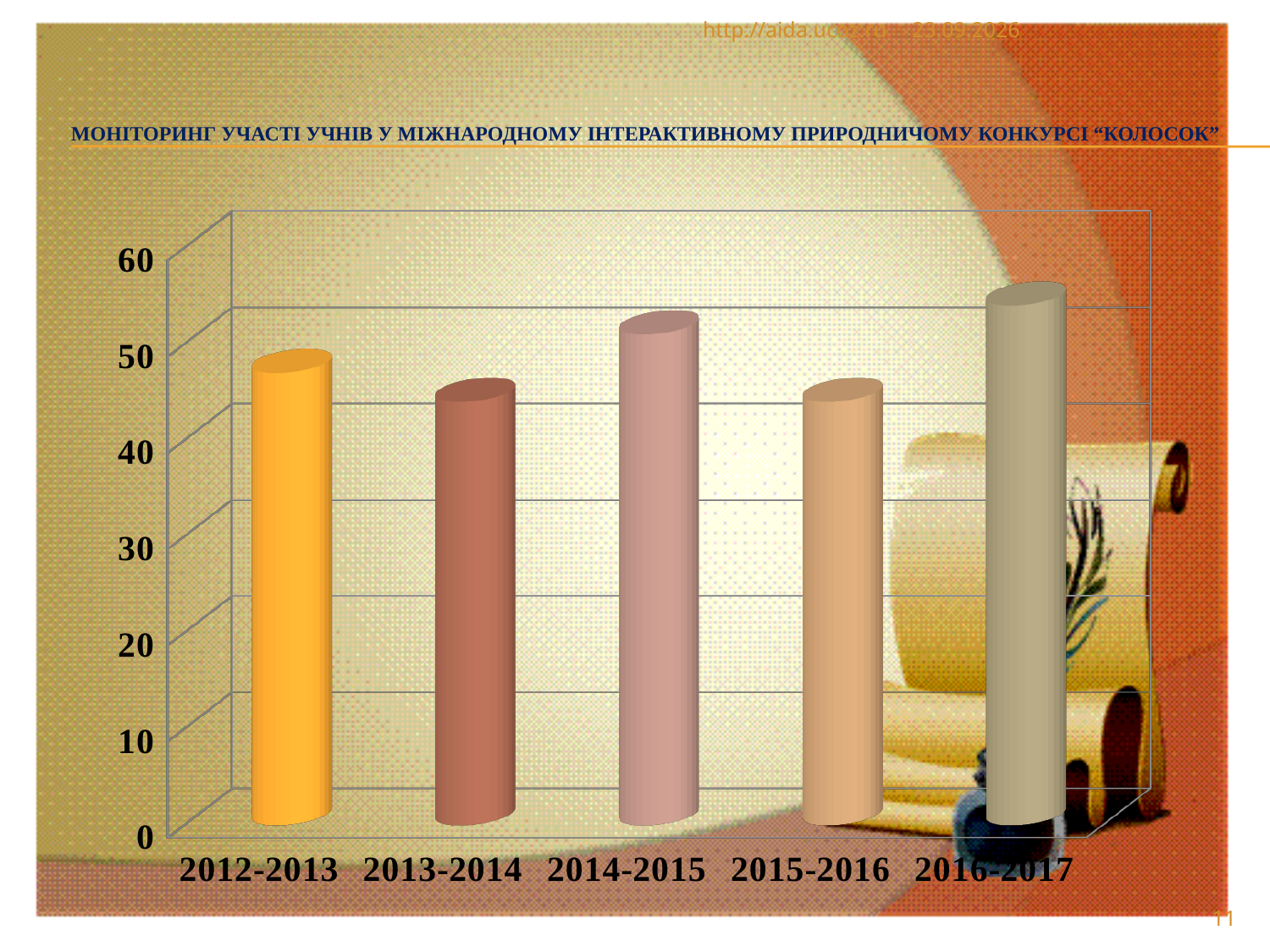
Is the value for 2015-2016 greater or less than 50? less Does the value rise or fall from 2015-2016 to 2016-2017? rise Is the value for 2012-2013 greater or less than 40? greater How many school-year categories are shown on the x axis of the chart? 5 Is the value for 2013-2014 greater or less than 50? less Which is larger, the value for 2014-2015 or the value for 2015-2016? 2014-2015 Which school year has the highest bar in the chart? 2016-2017 What is the highest tick value shown on the vertical axis of the chart? 60 Which school year is the first category on the x axis of the chart? 2012-2013 Which is larger, the value for 2016-2017 or the value for 2013-2014? 2016-2017 What kind of chart is shown on the slide? bar chart